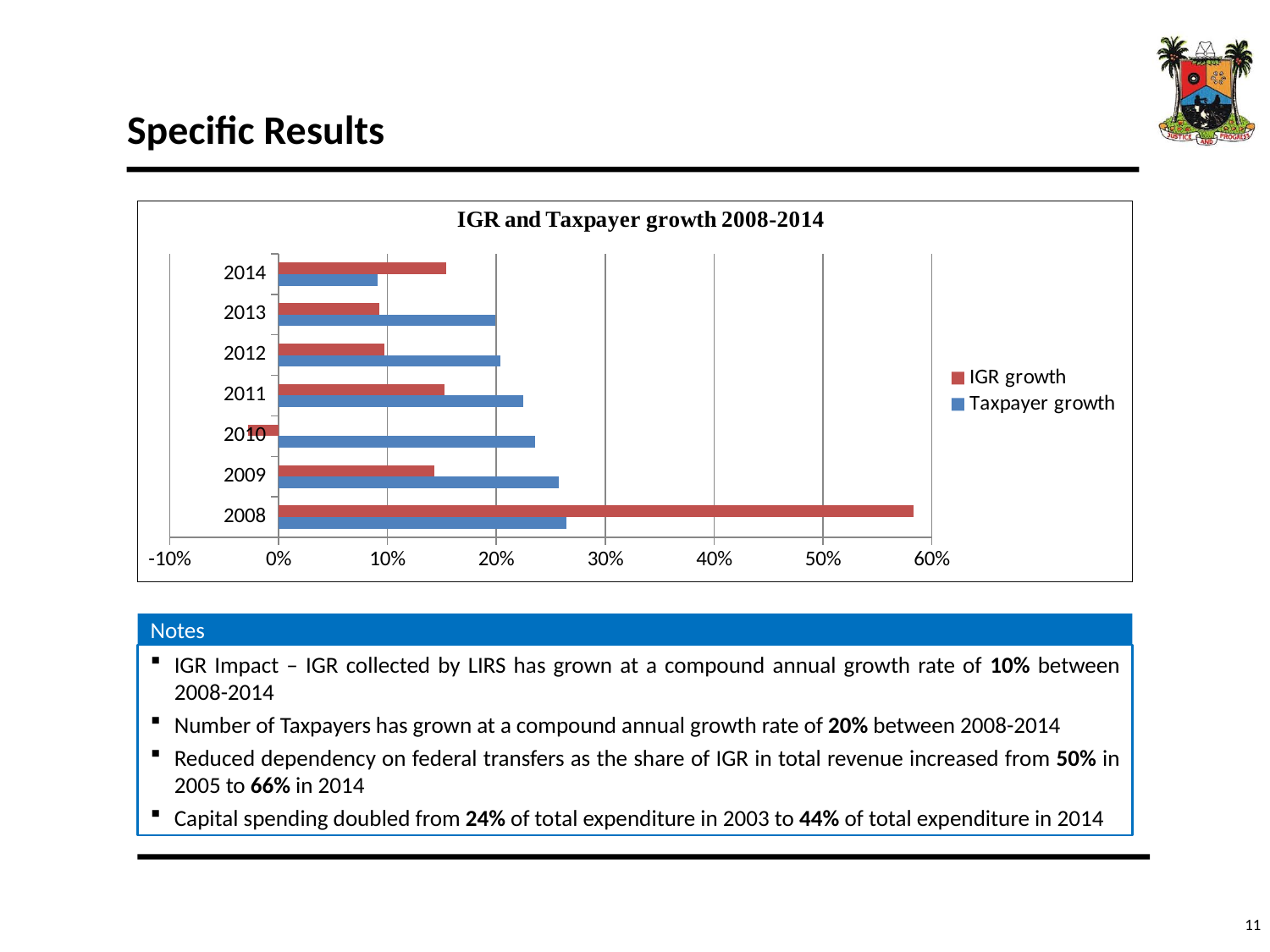
Which year has the highest IGR growth? 2008 Which year has the lowest Taxpayer growth? 2014 What kind of chart is shown on the slide? Bar chart Is the IGR growth for 2008 greater or less than 50%? greater How many years are shown on the y axis of the chart? 7 Is the Taxpayer growth for 2009 greater or less than 20%? greater In 2014, which is larger: IGR growth or Taxpayer growth? IGR growth In 2011, which is larger: IGR growth or Taxpayer growth? Taxpayer growth Which year has the lowest IGR growth? 2010 What is the title of the chart? IGR and Taxpayer growth 2008-2014 Is the IGR growth for 2010 greater or less than 0%? less How many series does the legend list in the IGR and Taxpayer growth chart? 2